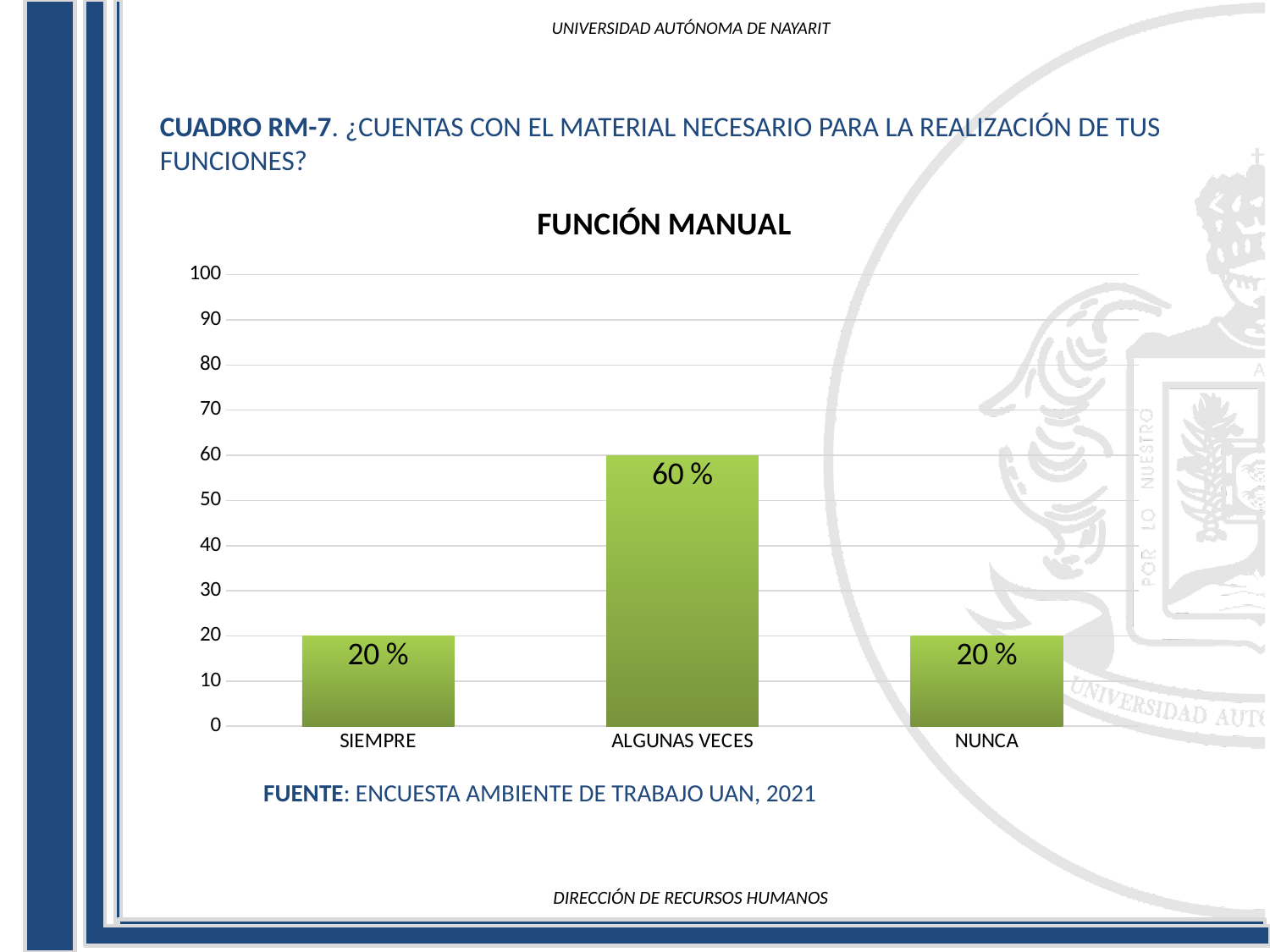
What is the value for NUNCA? 20 % What is the value for SIEMPRE? 20 % Is the value for SIEMPRE greater or less than 30? less How many categories are shown on the x axis? 3 Which category has the highest value? ALGUNAS VECES What is the highest value shown on the y axis? 100 What is the difference between the values for ALGUNAS VECES and SIEMPRE? 40 % Which is larger, the value for ALGUNAS VECES or the value for NUNCA? ALGUNAS VECES Is the value for ALGUNAS VECES greater or less than 50? greater What is the title of the chart? FUNCIÓN MANUAL What is the value for ALGUNAS VECES? 60 % What kind of chart is shown on the slide? bar chart